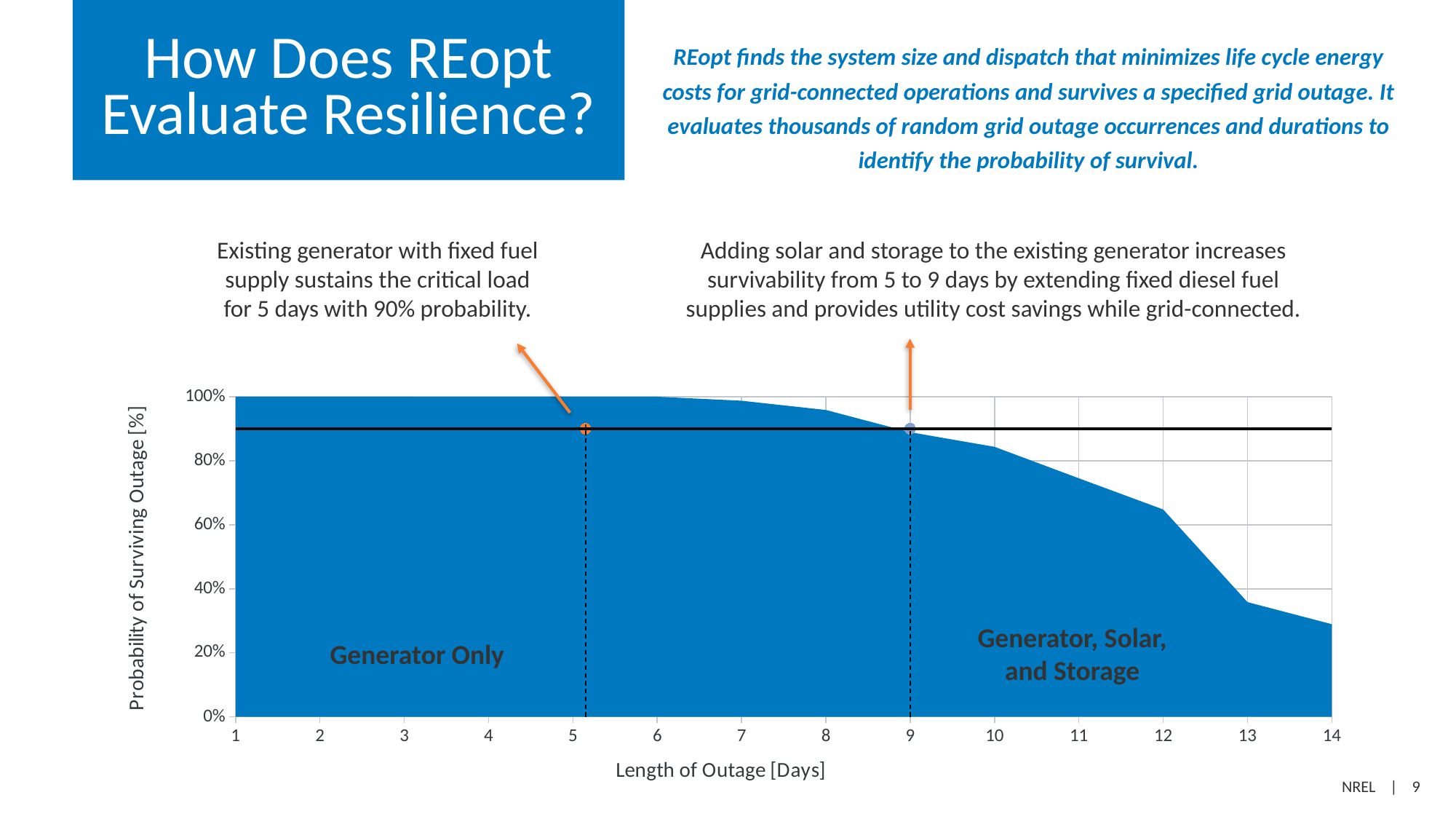
Does the probability of surviving the outage rise or fall as the length of outage increases? Fall Is the probability of surviving an outage of 13 days greater or less than 40%? less Which outage length has a higher probability of survival, 10 days or 13 days? 10 days Is the probability of surviving an outage of 12 days greater or less than 60%? greater How many day values are labelled along the x axis of the chart? 14 According to the chart annotations, for how many days does the generator-only system sustain the critical load with 90% probability? 5 days According to the chart annotations, for how many days does the generator, solar, and storage system sustain the critical load with 90% probability? 9 days Is the probability of surviving an outage of 14 days greater or less than 20%? greater What is the title of the x axis of the chart? Length of Outage [Days] At what probability level is the horizontal black line drawn on the chart? 90% What is the title of the y axis of the chart? Probability of Surviving Outage [%] What kind of chart is shown on the slide? Area chart